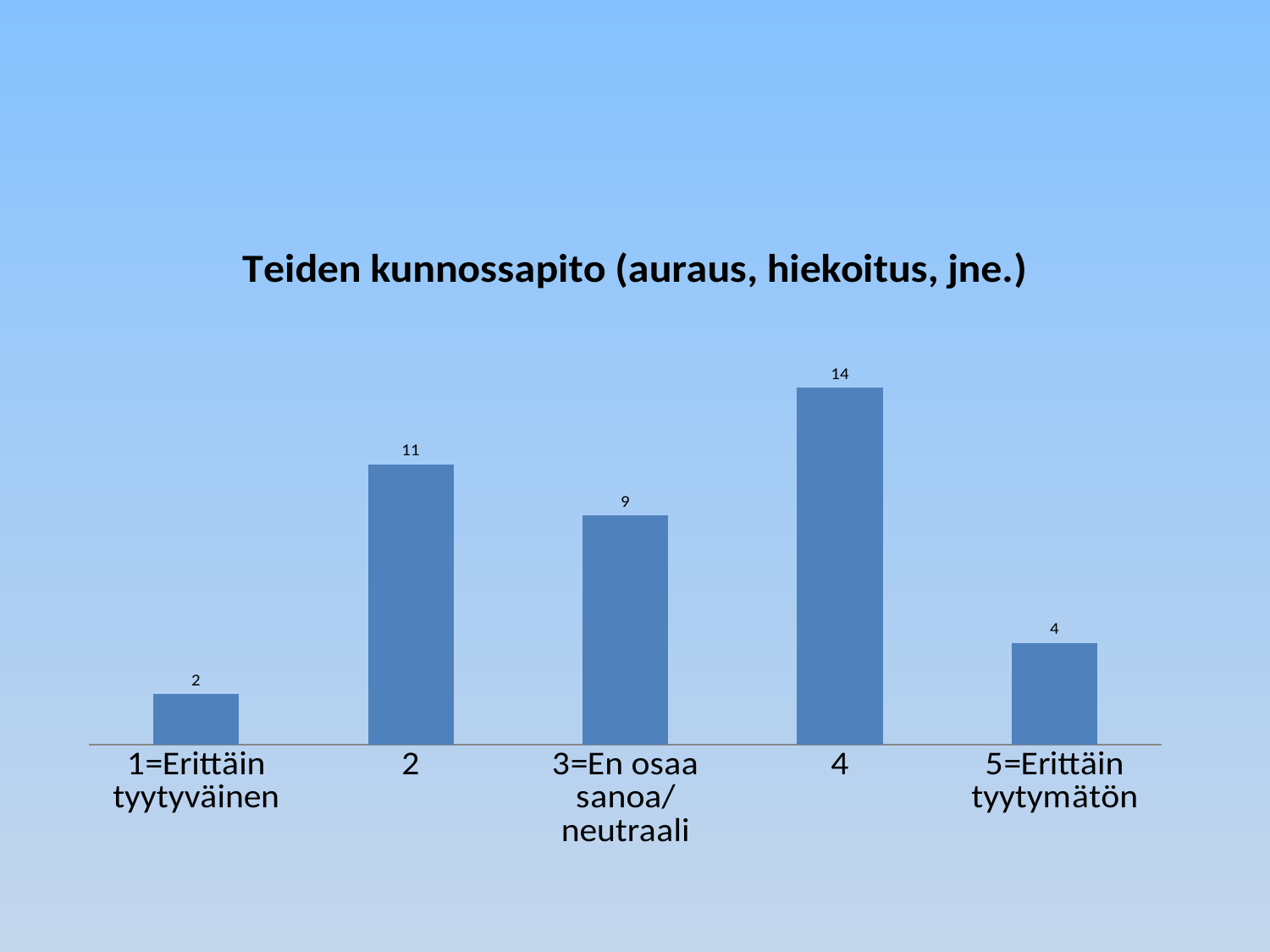
What kind of chart is this? bar chart How many categories are shown on the x axis? 5 What is the value for "1=Erittäin tyytyväinen"? 2 What is the value for the category "4"? 14 What is the value for "5=Erittäin tyytymätön"? 4 Which category has the highest value? 4 What is the difference between the values for "2" and "5=Erittäin tyytymätön"? 7 What is the difference between the values for "4" and "2"? 3 What is the value for "3=En osaa sanoa/neutraali"? 9 Which category has the lowest value? 1=Erittäin tyytyväinen Which is larger, the value for "2" or the value for "3=En osaa sanoa/neutraali"? 2 What is the title of the chart? Teiden kunnossapito (auraus, hiekoitus, jne.)